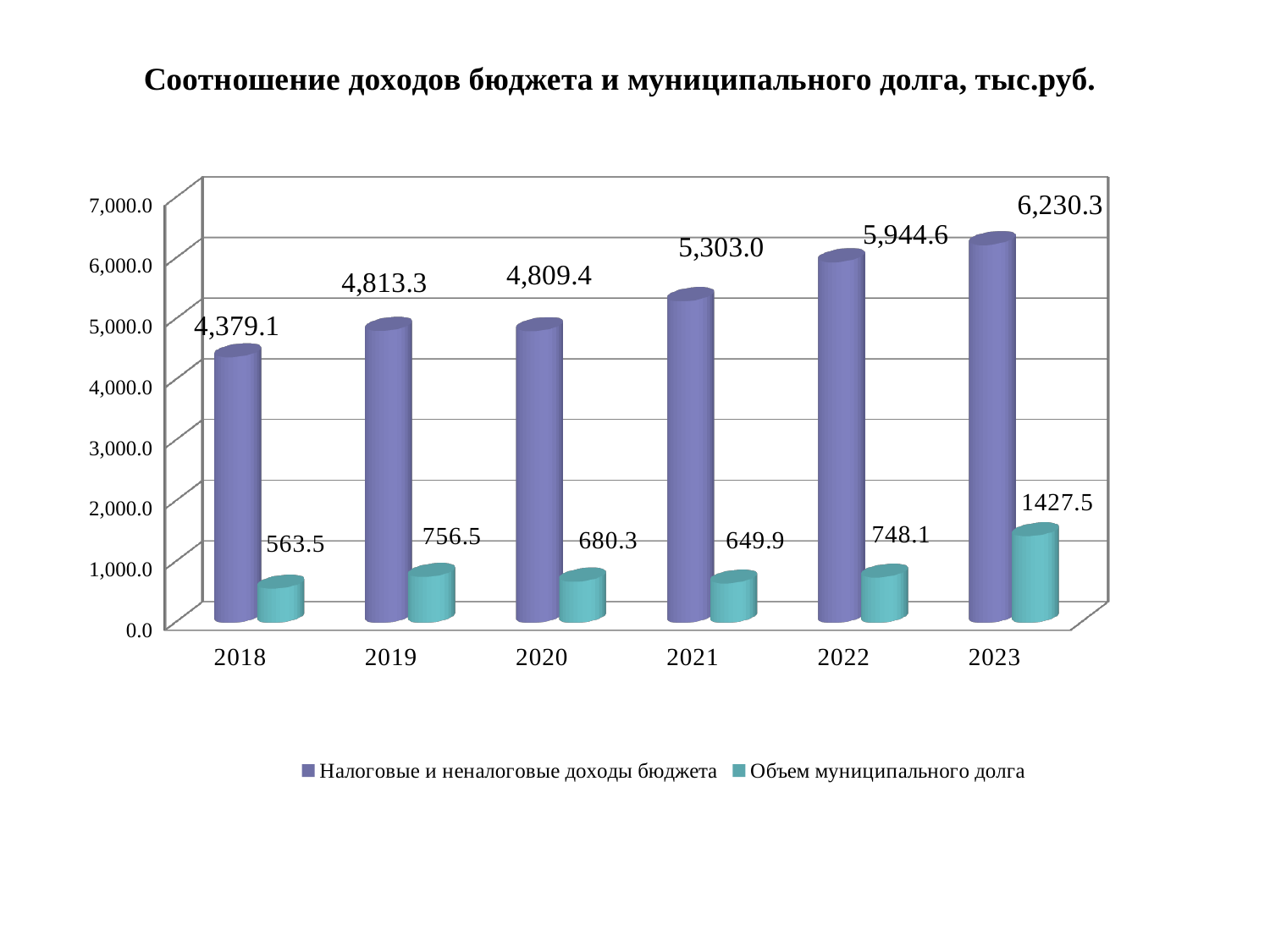
What is the value of Налоговые и неналоговые доходы бюджета for 2021? 5,303.0 Which is larger: Объем муниципального долга in 2019 or in 2021? 2019 How many series does the legend list? 2 How many years are shown on the x axis? 6 Do the values of Налоговые и неналоговые доходы бюджета generally rise or fall from 2018 to 2023? rise Is the value of Налоговые и неналоговые доходы бюджета for 2022 greater or less than 5,000.0? greater What is the difference between Налоговые и неналоговые доходы бюджета and Объем муниципального долга in 2023? 4,802.8 By how much did Объем муниципального долга increase from 2022 to 2023? 679.4 What kind of chart is shown on the slide? bar chart In which year is Налоговые и неналоговые доходы бюджета highest? 2023 In which year is Объем муниципального долга lowest? 2018 What is the value of Объем муниципального долга for 2019? 756.5